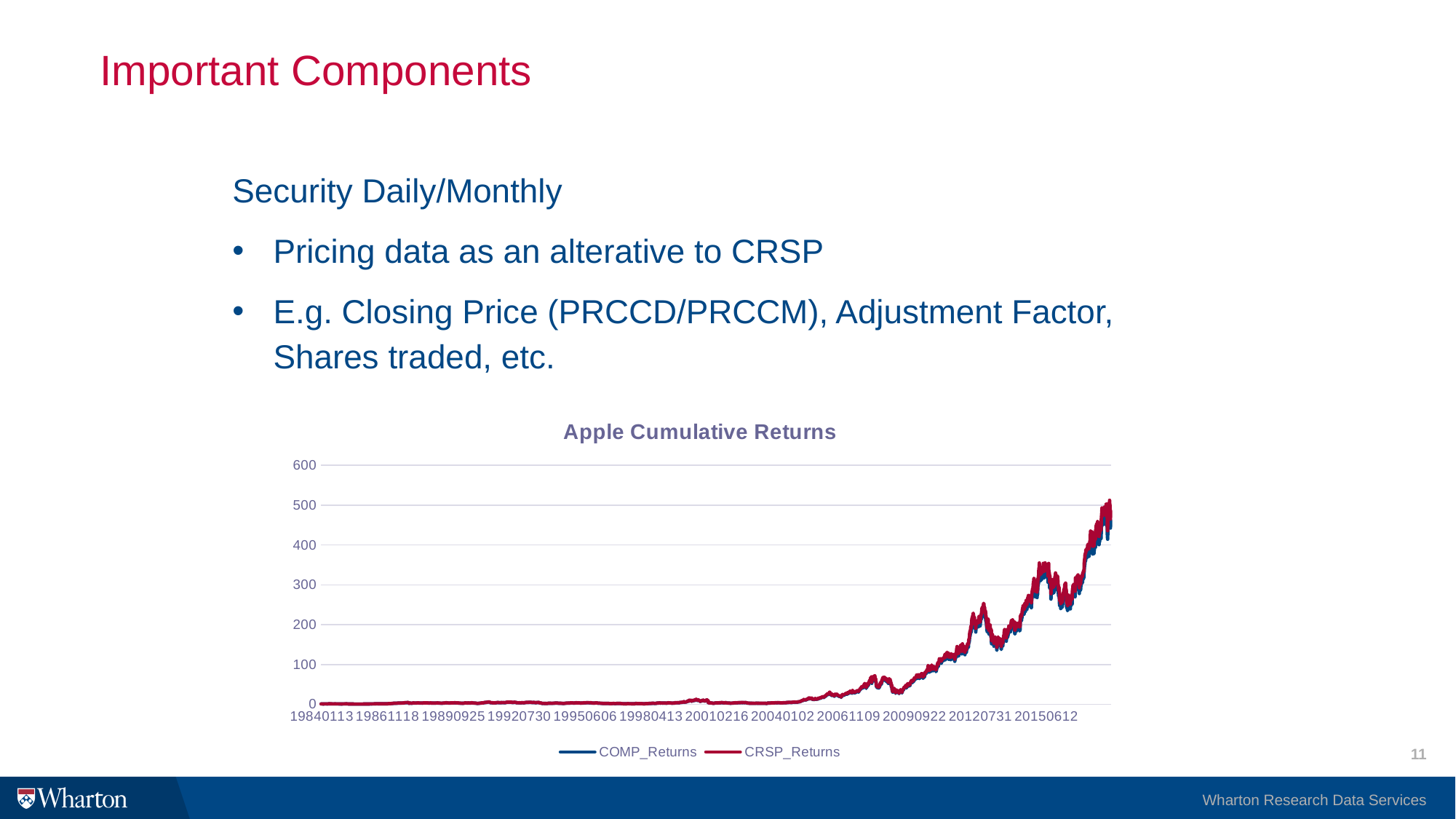
Is the value of the series around 20120731 greater or less than 100? greater Do the cumulative returns generally rise or fall from left to right along the x axis? rise What is the title of the chart? Apple Cumulative Returns Is the highest point reached by the series greater or less than 400? greater How many series does the chart's legend list? 2 What is the first date label on the x axis? 19840113 Is the value of the series around 20090922 greater or less than 100? less What are the names of the two series in the legend? COMP_Returns and CRSP_Returns What kind of chart is shown on the slide? line chart How many date labels are shown on the x axis? 12